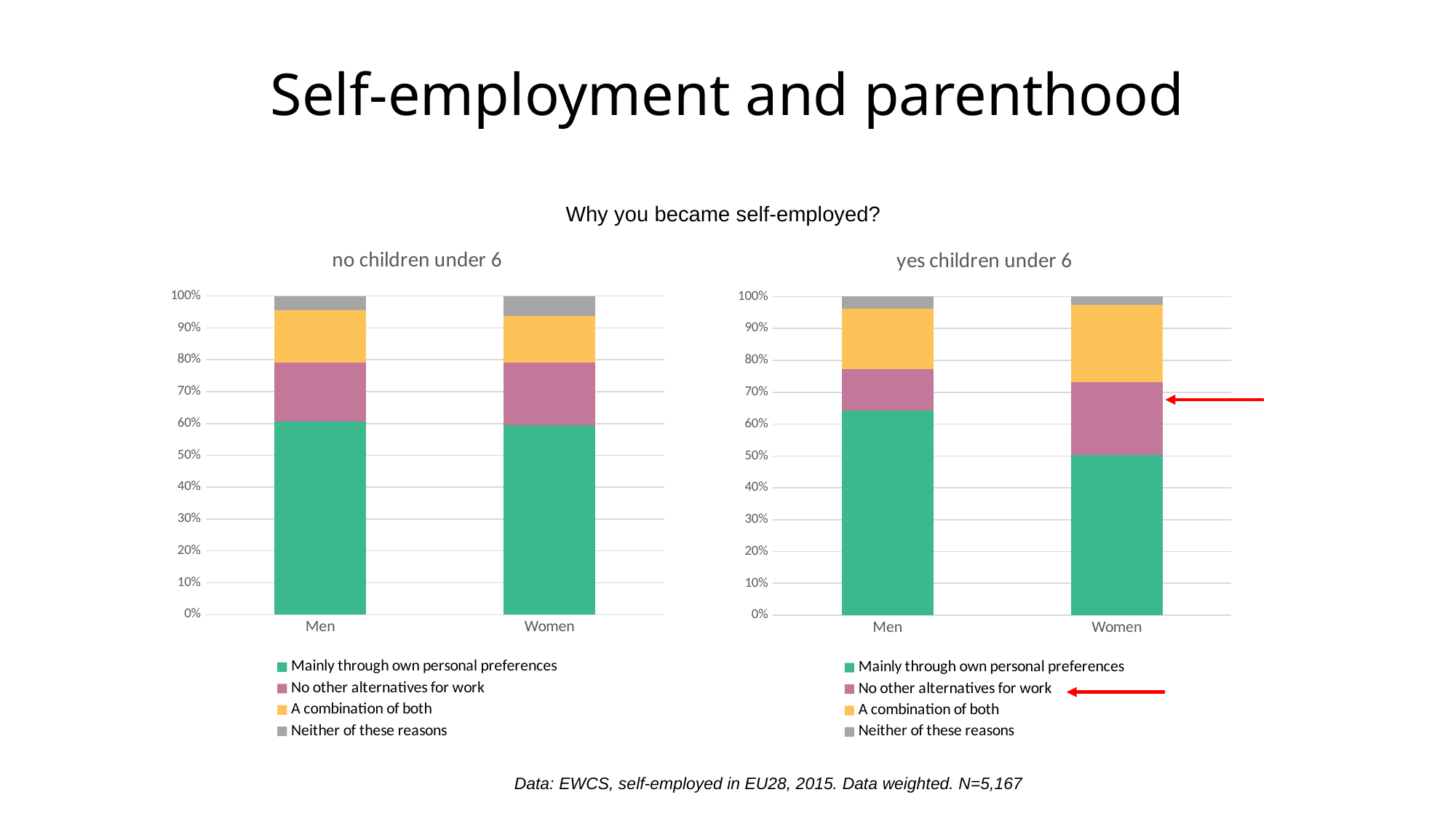
What kind of chart is the 'no children under 6' chart? bar chart In the 'yes children under 6' chart, which category has the larger 'Mainly through own personal preferences' share, Men or Women? Men What is the title of the chart on the right of the slide? yes children under 6 In the 'yes children under 6' chart, what is the total height of the stacked bar for Women? 100% In the 'yes children under 6' chart, is the 'Mainly through own personal preferences' share for Men greater or less than 60%? greater In the 'yes children under 6' chart, which category has the larger 'No other alternatives for work' share, Men or Women? Women In the 'yes children under 6' chart, is the 'Mainly through own personal preferences' share for Women greater or less than 60%? less In the 'no children under 6' chart, is the 'Mainly through own personal preferences' share for Men greater or less than 50%? greater How many series does the legend of the 'yes children under 6' chart list? 4 Which legend entry is marked by the red arrow on the 'yes children under 6' chart? No other alternatives for work How many categories are shown on the x axis of the 'no children under 6' chart? 2